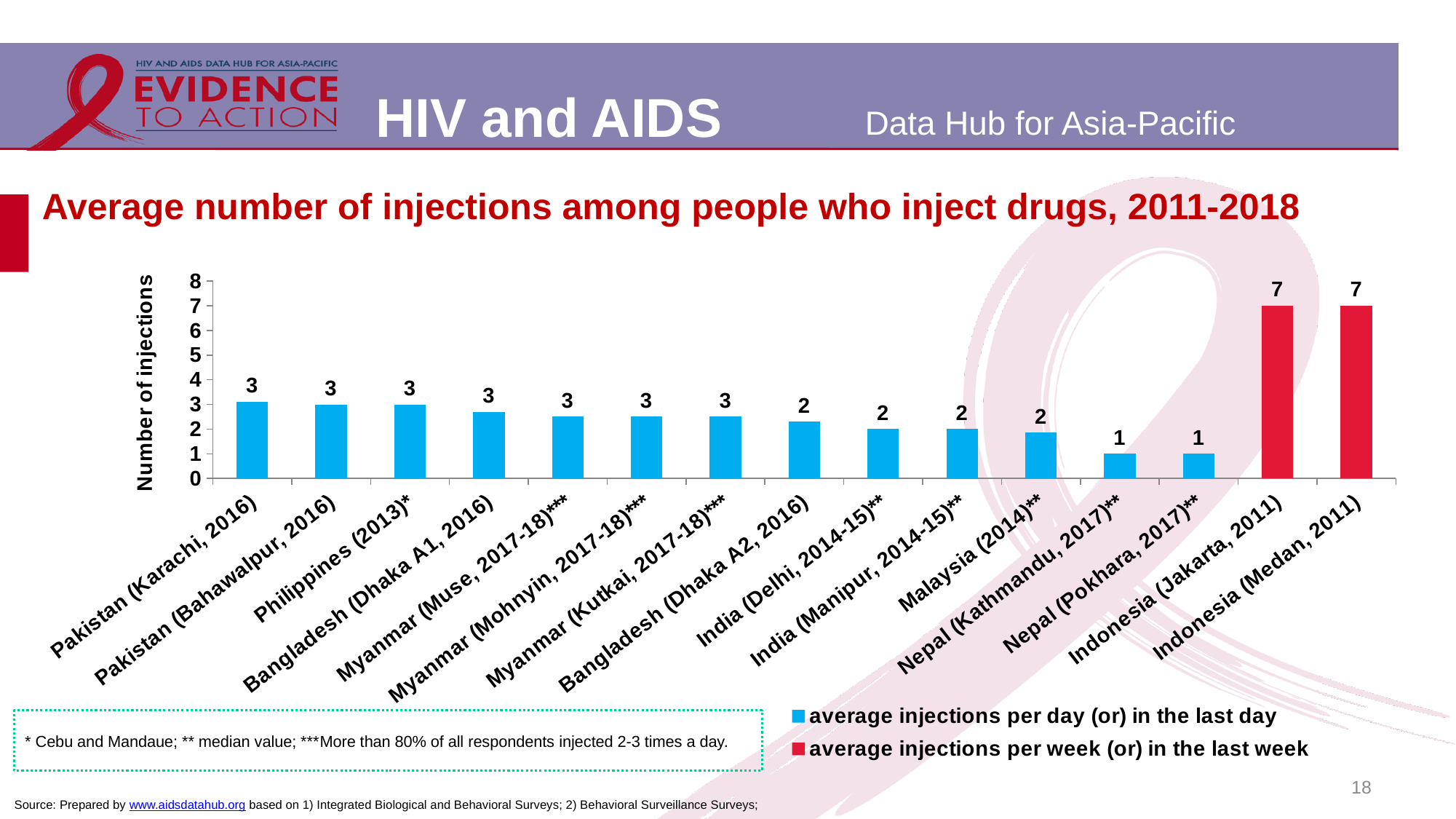
How many series does the legend list? 2 What is the value for Indonesia (Jakarta, 2011)? 7 What kind of chart is shown on the slide? bar chart How many categories are shown on the x axis? 15 Is the value for Pakistan (Bahawalpur, 2016) greater or less than 2? greater What is the value for Pakistan (Karachi, 2016)? 3 What is the value for Malaysia (2014)**? 2 Is the value for Bangladesh (Dhaka A2, 2016) greater or less than 3? less Which is larger, the value for Indonesia (Medan, 2011) or the value for Nepal (Kathmandu, 2017)**? Indonesia (Medan, 2011) What is the value for Nepal (Pokhara, 2017)**? 1 Which series do the red bars represent? average injections per week (or) in the last week What is the difference between the value for Indonesia (Jakarta, 2011) and the value for Nepal (Kathmandu, 2017)**? 6